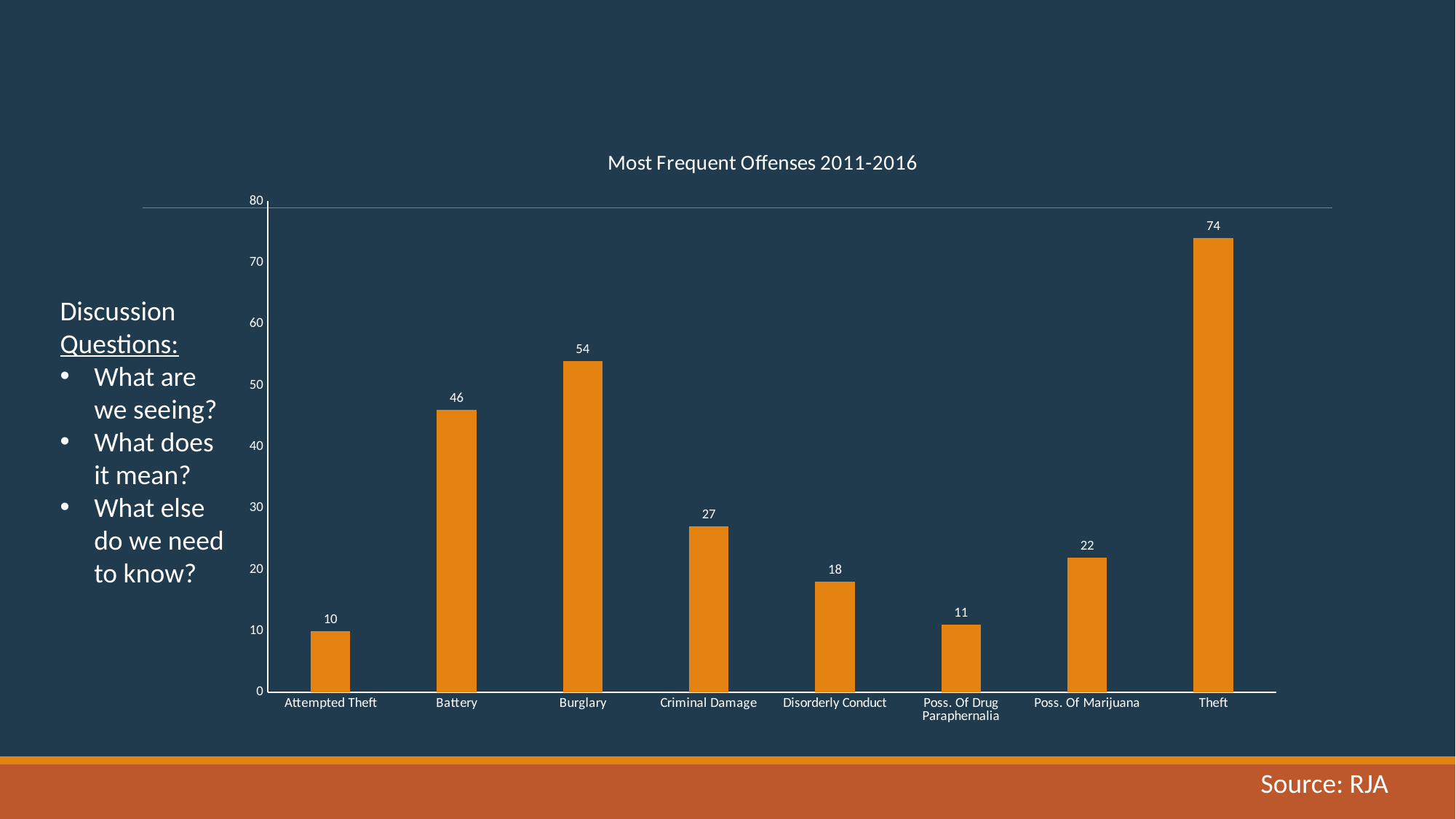
What is the value for Poss. Of Drug Paraphernalia? 11 Which offense has the highest value? Theft What is the value for Battery? 46 Which offense has the lowest value? Attempted Theft Which is larger, the value for Criminal Damage or the value for Poss. Of Marijuana? Criminal Damage What is the title of the chart? Most Frequent Offenses 2011-2016 What kind of chart is shown on the slide? bar chart Is the value for Burglary greater or less than 50? greater What is the difference between the values for Theft and Burglary? 20 How many offense categories are shown on the chart? 8 What is the difference between the values for Disorderly Conduct and Attempted Theft? 8 What is the value for Theft? 74